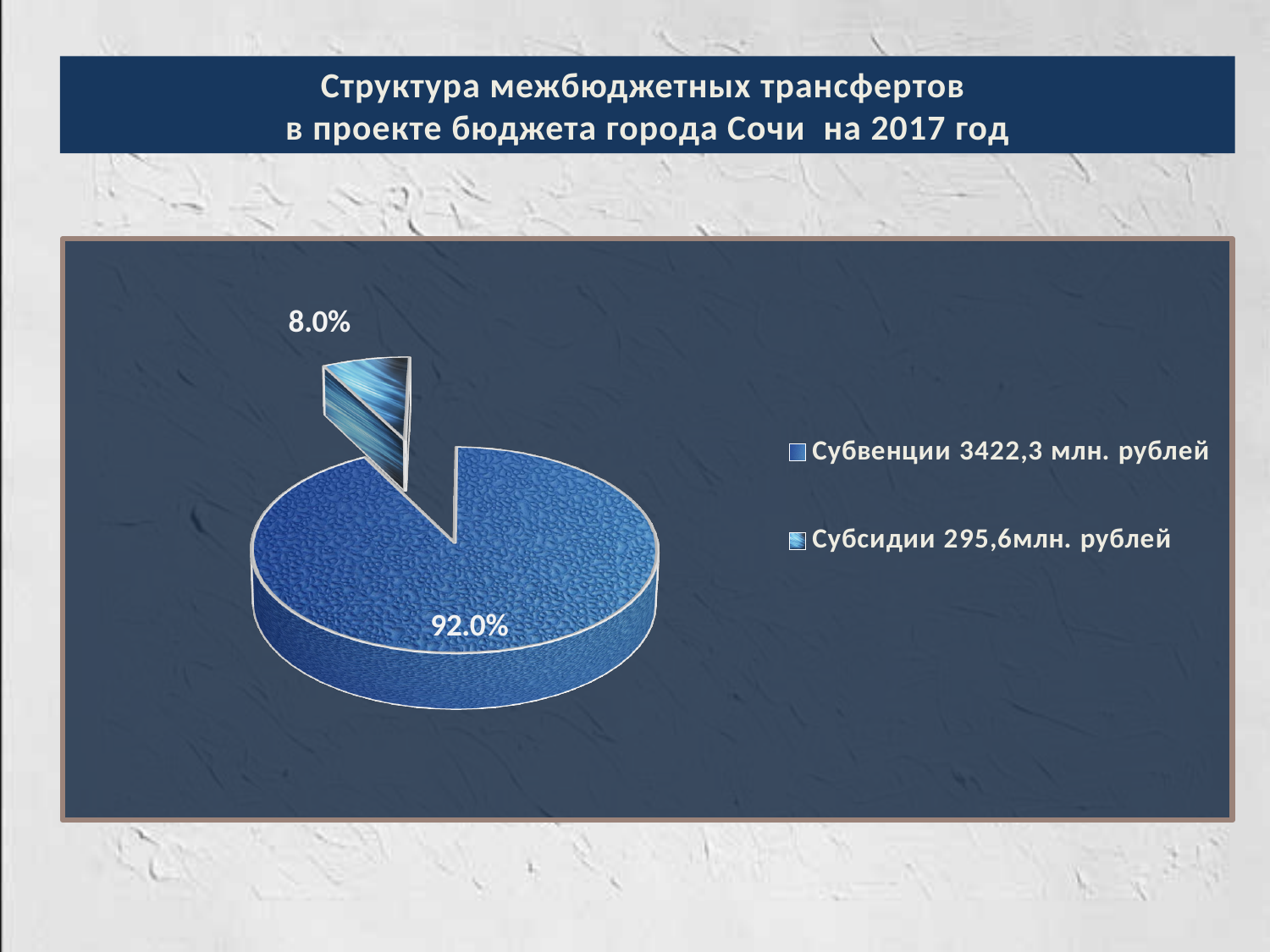
Which category has the smallest share of the pie? Субсидии What is the title of the slide? Структура межбюджетных трансфертов в проекте бюджета города Сочи на 2017 год How many entries does the legend list? 2 What share of the pie does the Субвенции slice represent? 92.0% What share of the pie does the Субсидии slice represent? 8.0% How many slices does the pie chart have? 2 Which category has the largest share of the pie? Субвенции Which is larger, the share for Субвенции or the share for Субсидии? Субвенции What amount in млн. рублей is shown in the legend for Субсидии? 295,6 млн. рублей What amount in млн. рублей is shown in the legend for Субвенции? 3422,3 млн. рублей What kind of chart is shown on the slide? Pie chart What is the difference in percentage points between the Субвенции share and the Субсидии share? 84.0 percentage points